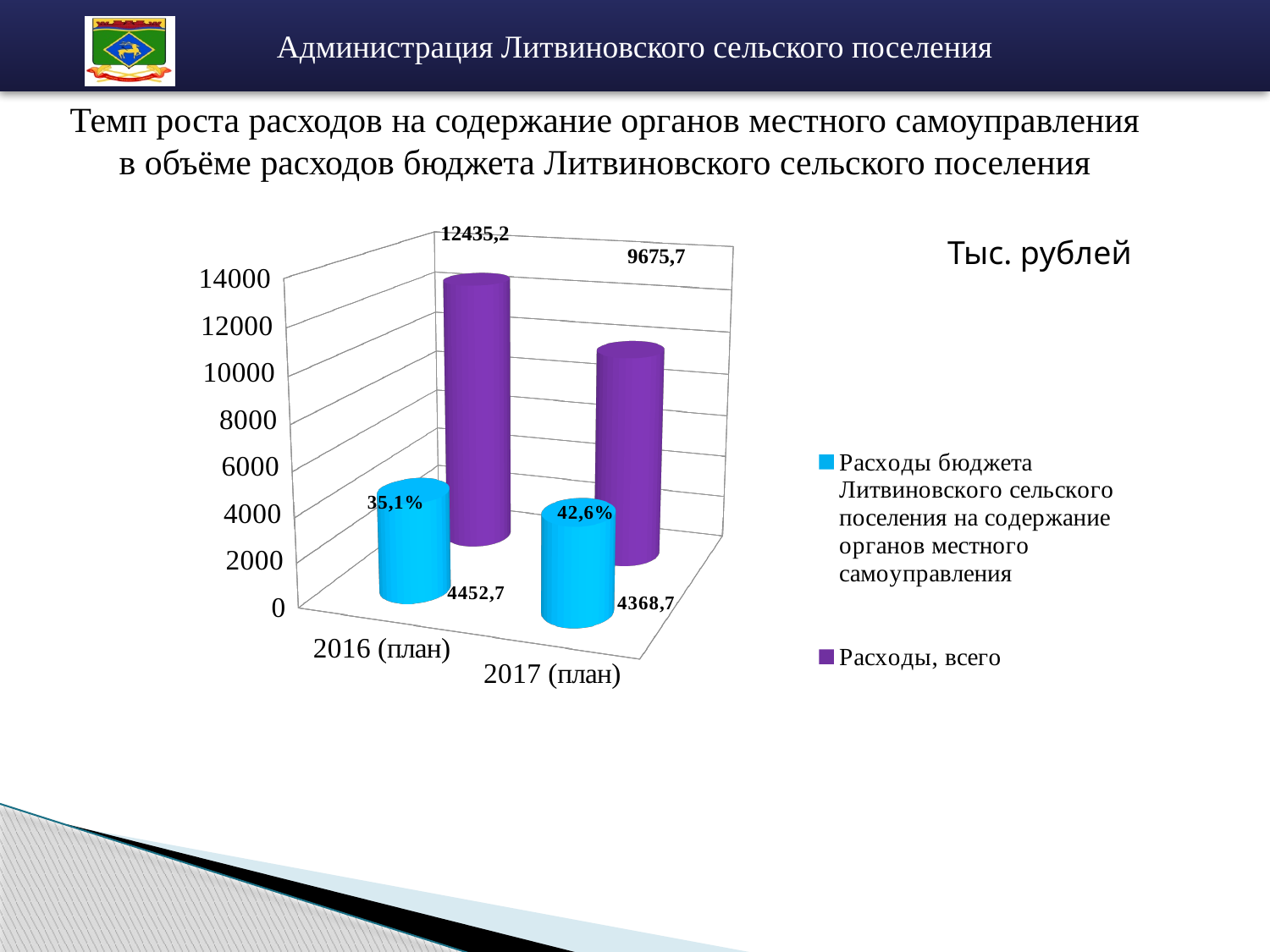
How many series does the legend list? 2 What is the value of "Расходы, всего" for 2017 (план)? 9675,7 How many categories are shown on the x axis? 2 Which is larger: "Расходы, всего" for 2016 (план) or for 2017 (план)? 2016 (план) What is the difference between "Расходы, всего" in 2016 (план) and 2017 (план)? 2759,5 What is the value of "Расходы бюджета Литвиновского сельского поселения на содержание органов местного самоуправления" for 2016 (план)? 4452,7 In which year is "Расходы, всего" highest? 2016 (план) What kind of chart is shown on the slide? Bar chart What percentage label is shown on the blue bar for 2017 (план)? 42,6% What is the value of "Расходы, всего" for 2016 (план)? 12435,2 What is the value of "Расходы бюджета Литвиновского сельского поселения на содержание органов местного самоуправления" for 2017 (план)? 4368,7 What percentage label is shown on the blue bar for 2016 (план)? 35,1%